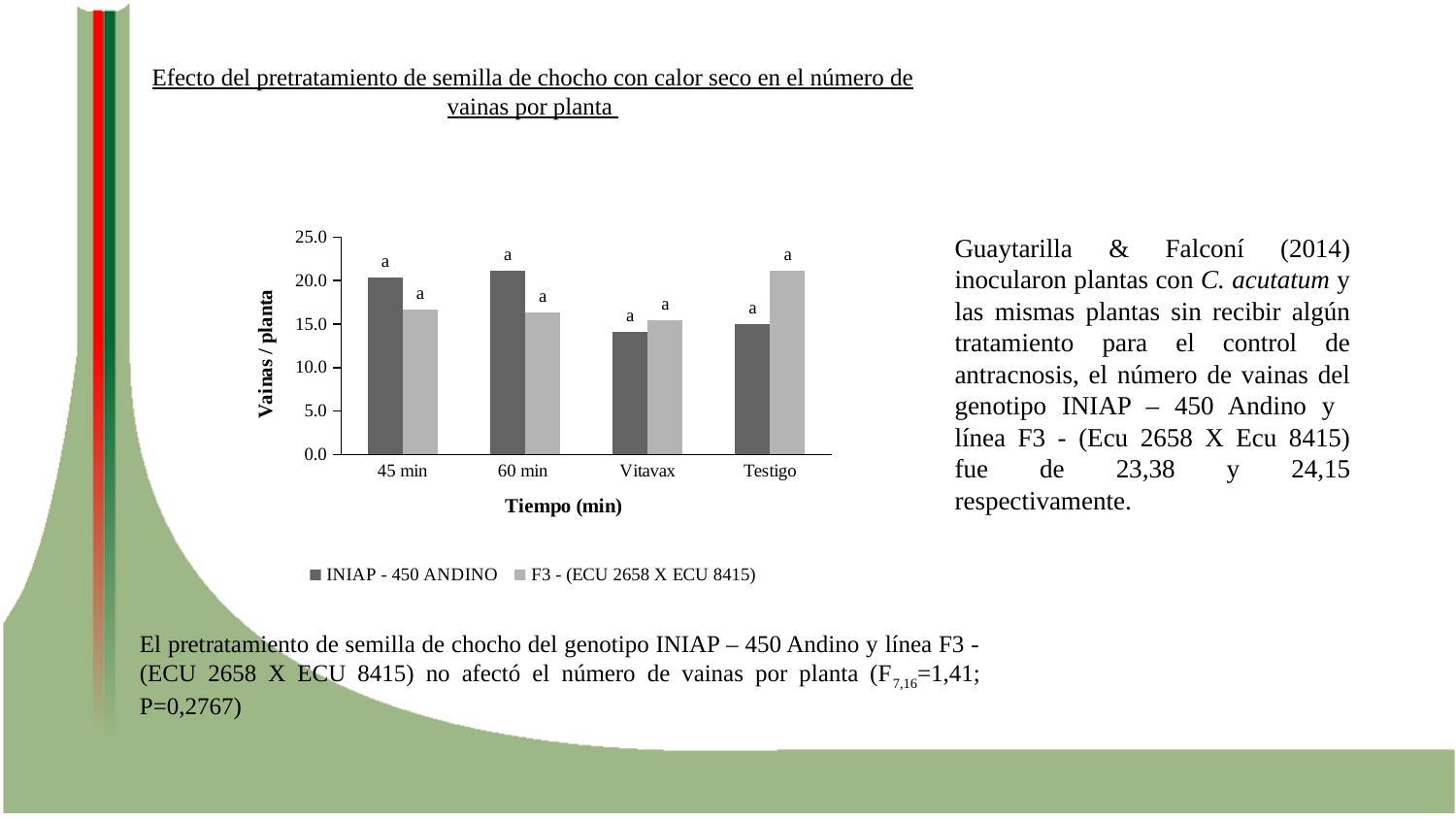
Is the value for INIAP - 450 ANDINO at Vitavax greater or less than 15.0? less What is the title of the y axis of the chart? Vainas / planta Is the value for INIAP - 450 ANDINO at 60 min greater or less than 20.0? greater What is the title of the x axis of the chart? Tiempo (min) How many categories are shown on the x axis of the chart? 4 Which category has the highest value for the F3 - (ECU 2658 X ECU 8415) series? Testigo Is the value for F3 - (ECU 2658 X ECU 8415) at Testigo greater or less than 20.0? greater Which category has the lowest value for the INIAP - 450 ANDINO series? Vitavax For Testigo, which series has the larger value, INIAP - 450 ANDINO or F3 - (ECU 2658 X ECU 8415)? F3 - (ECU 2658 X ECU 8415) What kind of chart is shown on the slide? bar chart At 45 min, which series has the larger value, INIAP - 450 ANDINO or F3 - (ECU 2658 X ECU 8415)? INIAP - 450 ANDINO How many series does the chart legend list? 2